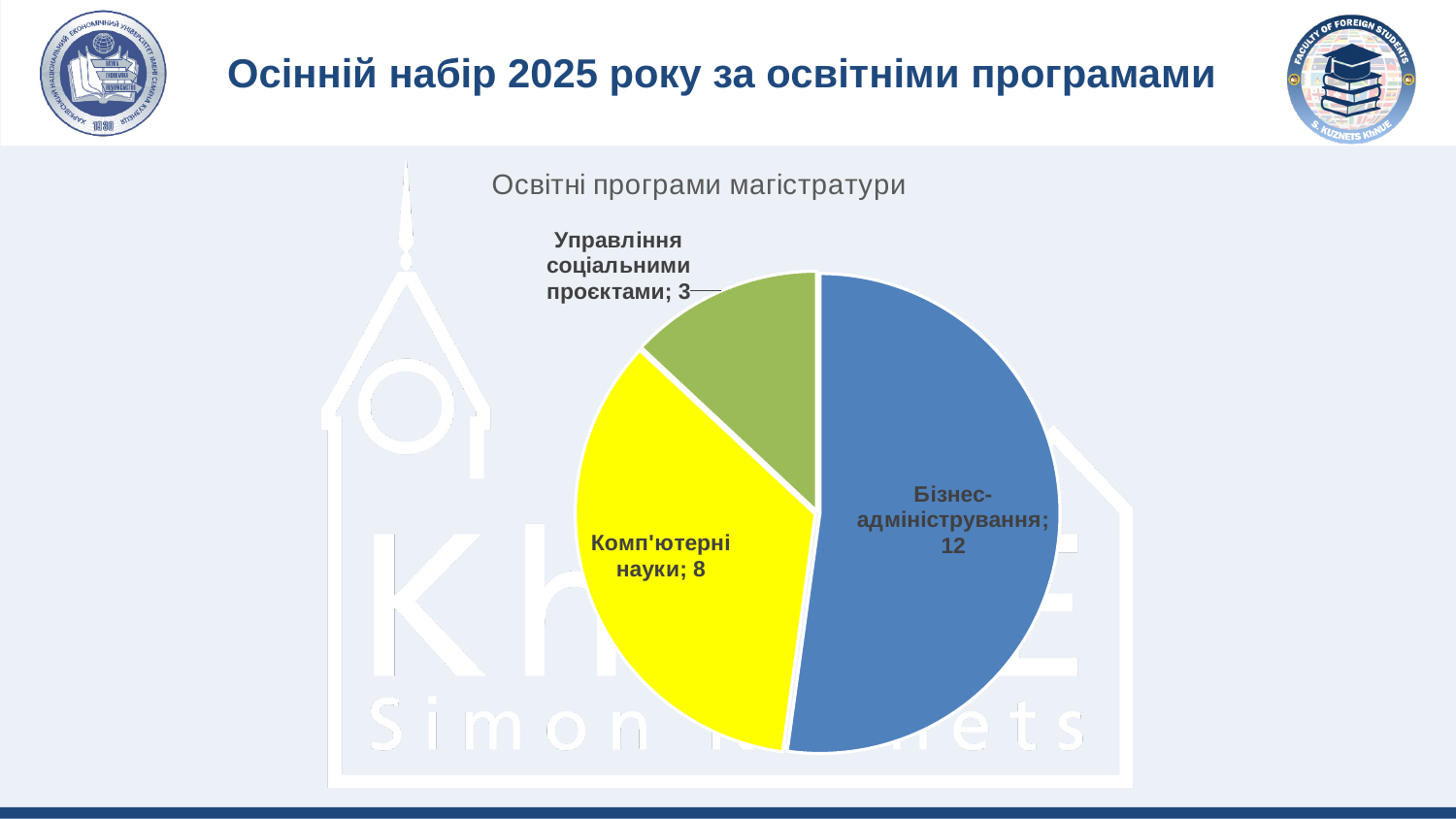
What is the difference between the values for Бізнес-адміністрування and Комп'ютерні науки? 4 What colour is the slice for Комп'ютерні науки? Yellow Which is larger: the value for Комп'ютерні науки or the value for Управління соціальними проєктами? Комп'ютерні науки What is the total of all slices in the pie chart? 23 What is the value for Управління соціальними проєктами? 3 How many slices (categories) does the pie chart have? 3 What is the value for Бізнес-адміністрування? 12 Which category has the smallest slice of the pie? Управління соціальними проєктами What is the title of the chart? Освітні програми магістратури What is the value for Комп'ютерні науки? 8 Which category has the largest slice of the pie? Бізнес-адміністрування What type of chart is shown on the slide? Pie chart